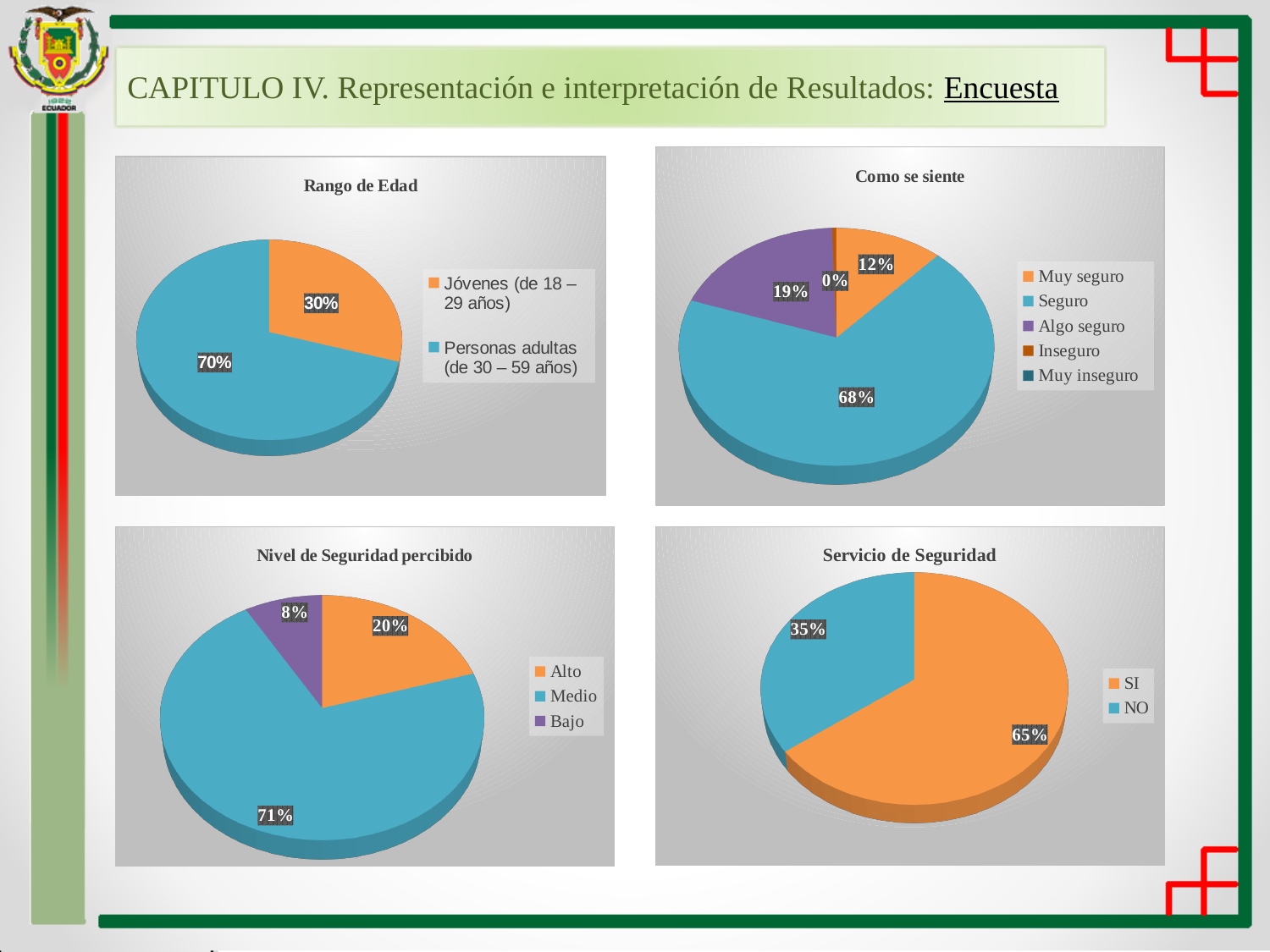
In the 'Rango de Edad' chart, what is the value for Jóvenes (de 18 – 29 años)? 30% What kind of chart is the 'Servicio de Seguridad' chart? Pie chart In the 'Como se siente' chart, what is the value for Algo seguro? 19% How many entries does the legend of the 'Como se siente' chart list? 5 In the 'Servicio de Seguridad' chart, which is larger, SI or NO? SI In the 'Rango de Edad' chart, what share is shown for Personas adultas (de 30 – 59 años)? 70% In the 'Como se siente' chart, what is the value for Muy seguro? 12% In the 'Como se siente' chart, which category has the largest slice? Seguro In the 'Servicio de Seguridad' chart, what is the value for NO? 35% In the 'Nivel de Seguridad percibido' chart, what is the value for Medio? 71% In the 'Nivel de Seguridad percibido' chart, what is the difference between Alto and Bajo? 12% In the 'Nivel de Seguridad percibido' chart, which category has the smallest slice? Bajo